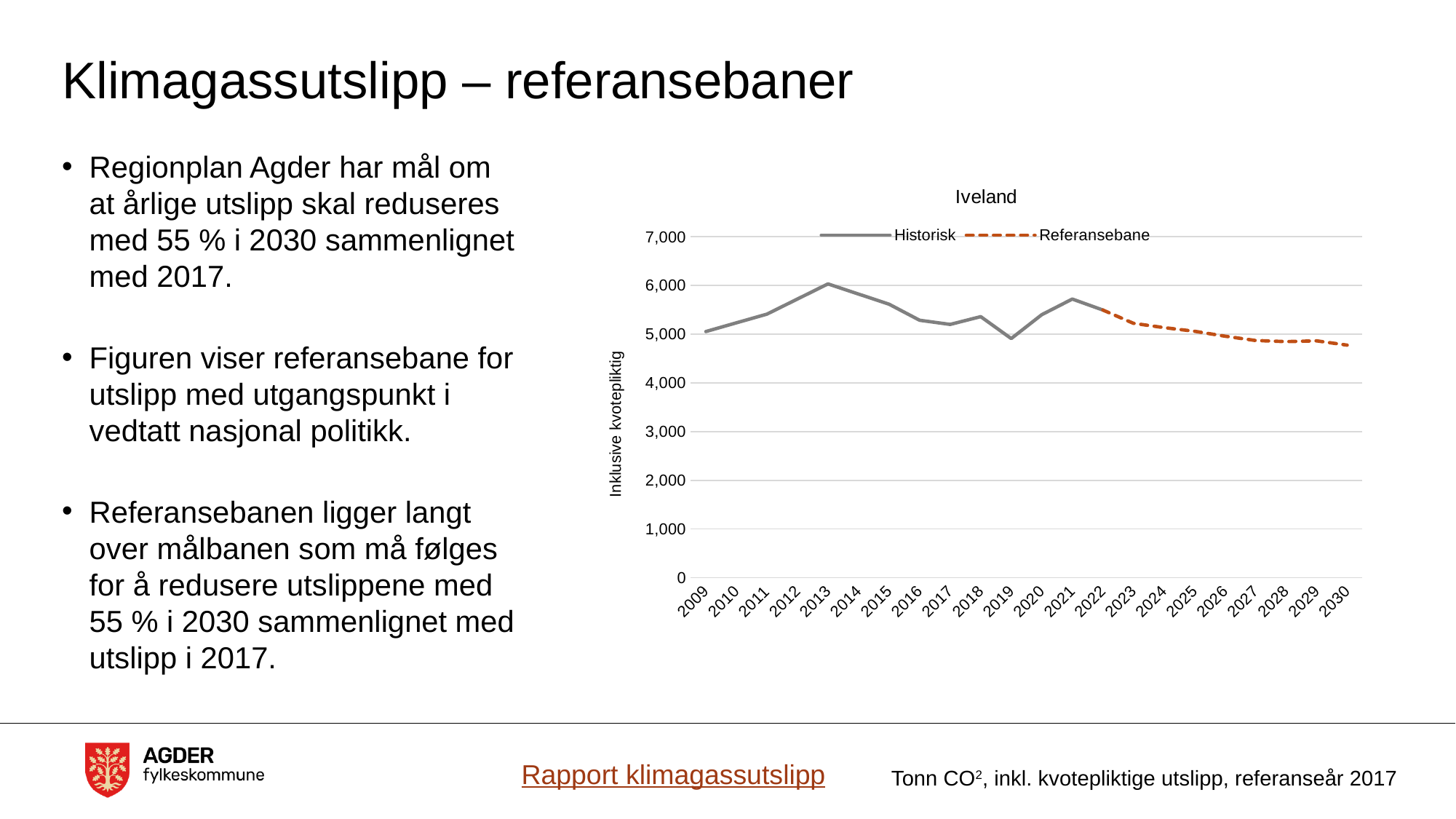
Which year has the larger Historisk value, 2013 or 2019? 2013 How many series does the chart legend list? 2 Is the Referansebane value for 2030 greater or less than 5,000? less Is the Historisk value for 2013 greater or less than 5,000? greater Which year has the larger Historisk value, 2021 or 2019? 2021 Does the Referansebane series rise or fall from 2022 to 2030? fall What is the title of the chart? Iveland Is the Historisk value for 2009 greater or less than 4,000? greater What kind of chart is shown on the slide? line chart In which year does the Historisk series reach its highest value? 2013 What are the names of the two series in the chart legend? Historisk and Referansebane How many years are shown on the x axis of the chart? 22